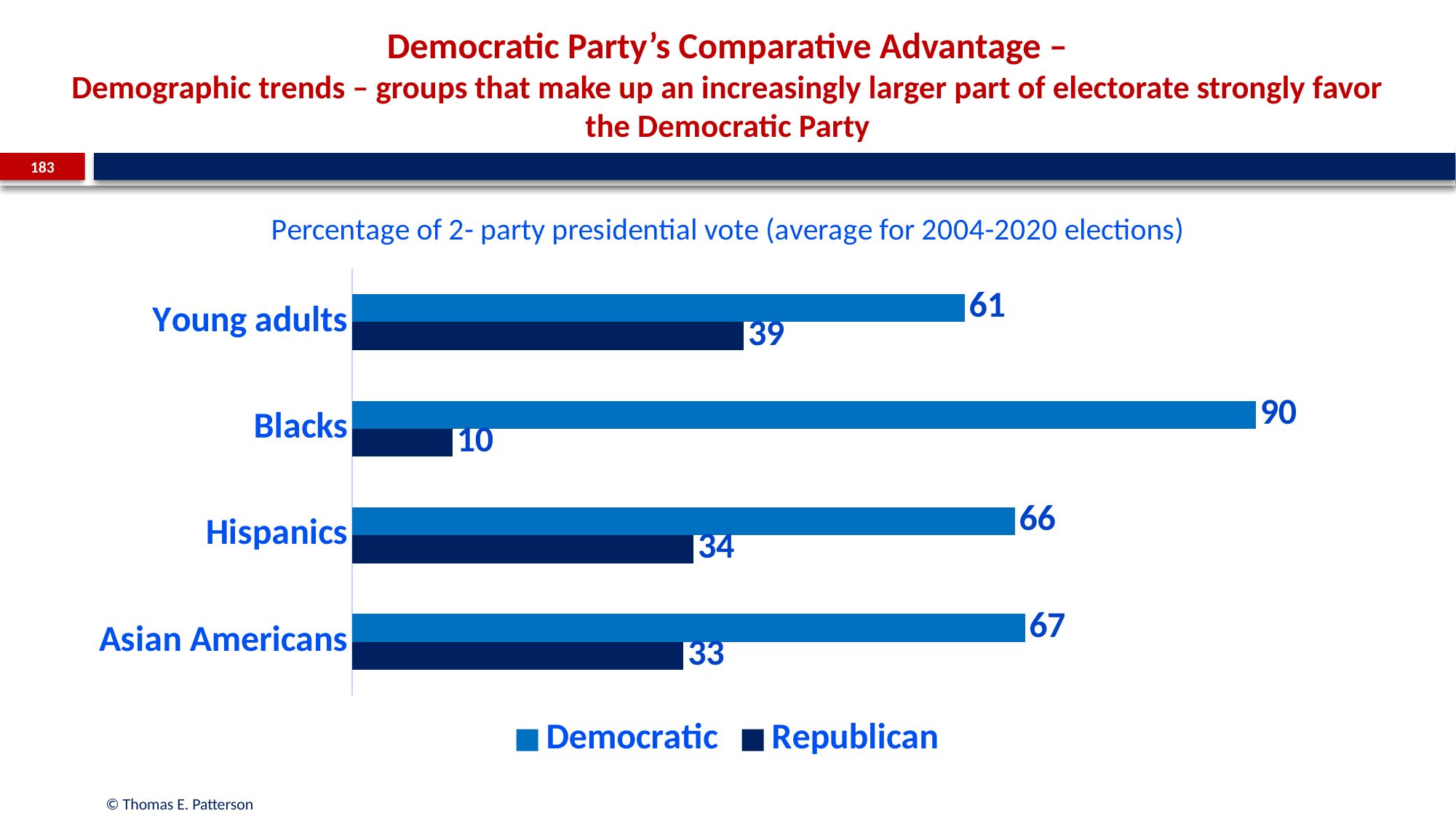
Which is larger, the Democratic value for Young adults or the Democratic value for Hispanics? Democratic value for Hispanics What is the title of the chart? Percentage of 2- party presidential vote (average for 2004-2020 elections) What kind of chart is shown on the slide? Bar chart What is the Democratic value for Blacks? 90 What is the Republican value for Young adults? 39 What is the Democratic value for Hispanics? 66 Which group has the highest Democratic value? Blacks Which group has the lowest Republican value? Blacks How many groups are shown on the chart? 4 What is the Republican value for Asian Americans? 33 What is the difference between the Democratic and Republican values for Blacks? 80 How many series does the legend list? 2